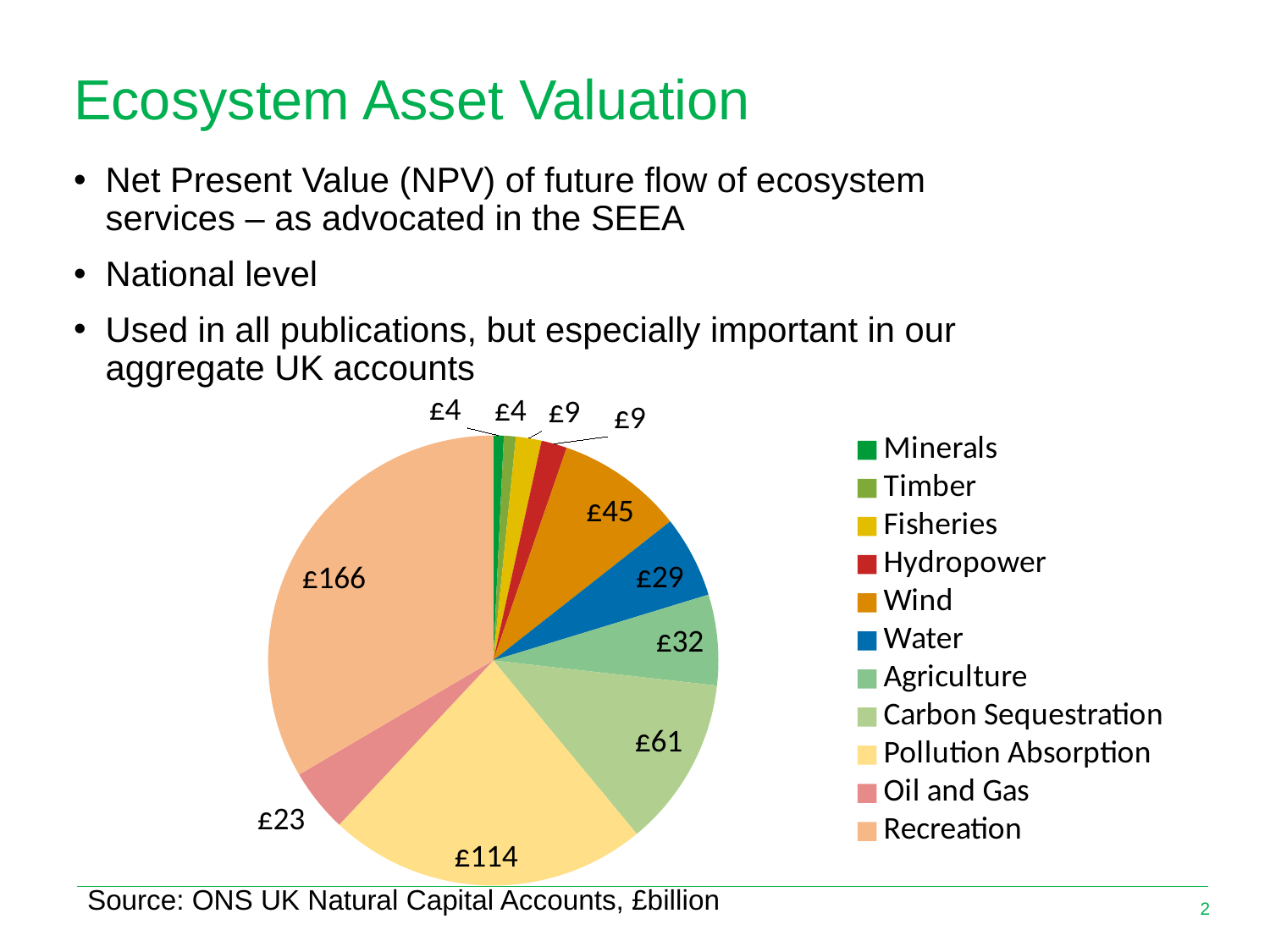
Which category has the largest slice in the pie chart? Recreation What is the value shown for Pollution Absorption in the pie chart? £114 What is the value shown for Recreation in the pie chart? £166 What is the value shown for Oil and Gas in the pie chart? £23 What is the difference between the values for Carbon Sequestration and Agriculture? £29 What is the difference between the values for Recreation and Pollution Absorption? £52 Which is larger, the value for Wind or the value for Carbon Sequestration? Carbon Sequestration What type of chart is shown on the slide? Pie chart How many categories does the pie chart show? 11 According to the source note, what unit are the values in the chart expressed in? £billion Which is larger, the value for Water or the value for Agriculture? Agriculture What is the value shown for Wind in the pie chart? £45